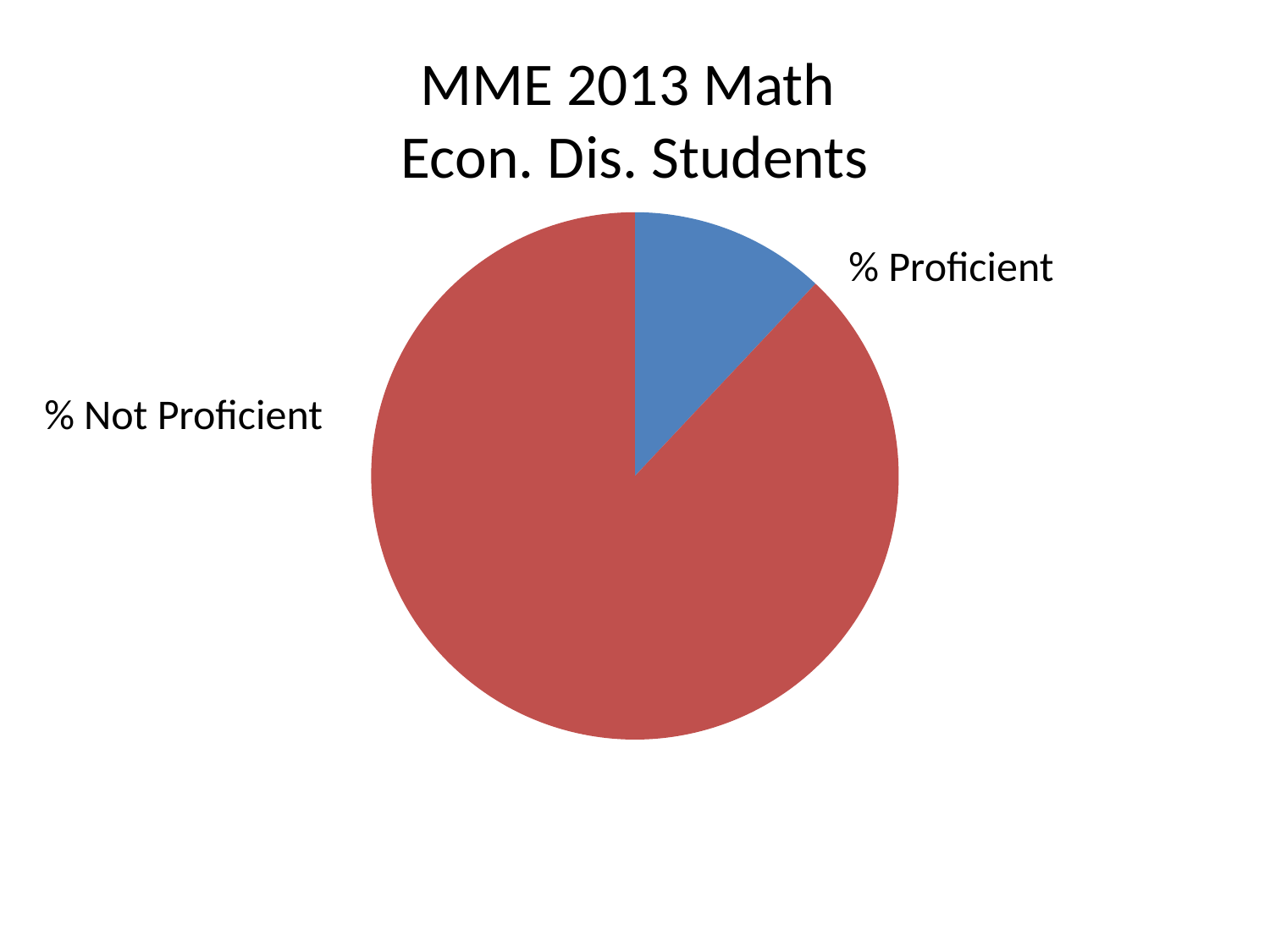
Is the share of the % Proficient slice greater or less than 25%? less How many slices does the pie chart have? 2 What is the title of the chart? MME 2013 Math Econ. Dis. Students Which slice is the smallest? % Proficient What colour is the % Proficient slice? blue What kind of chart is shown on the slide? pie chart Is the share of the % Not Proficient slice greater or less than 50%? greater Which slice is the largest? % Not Proficient Which slice is larger, % Proficient or % Not Proficient? % Not Proficient